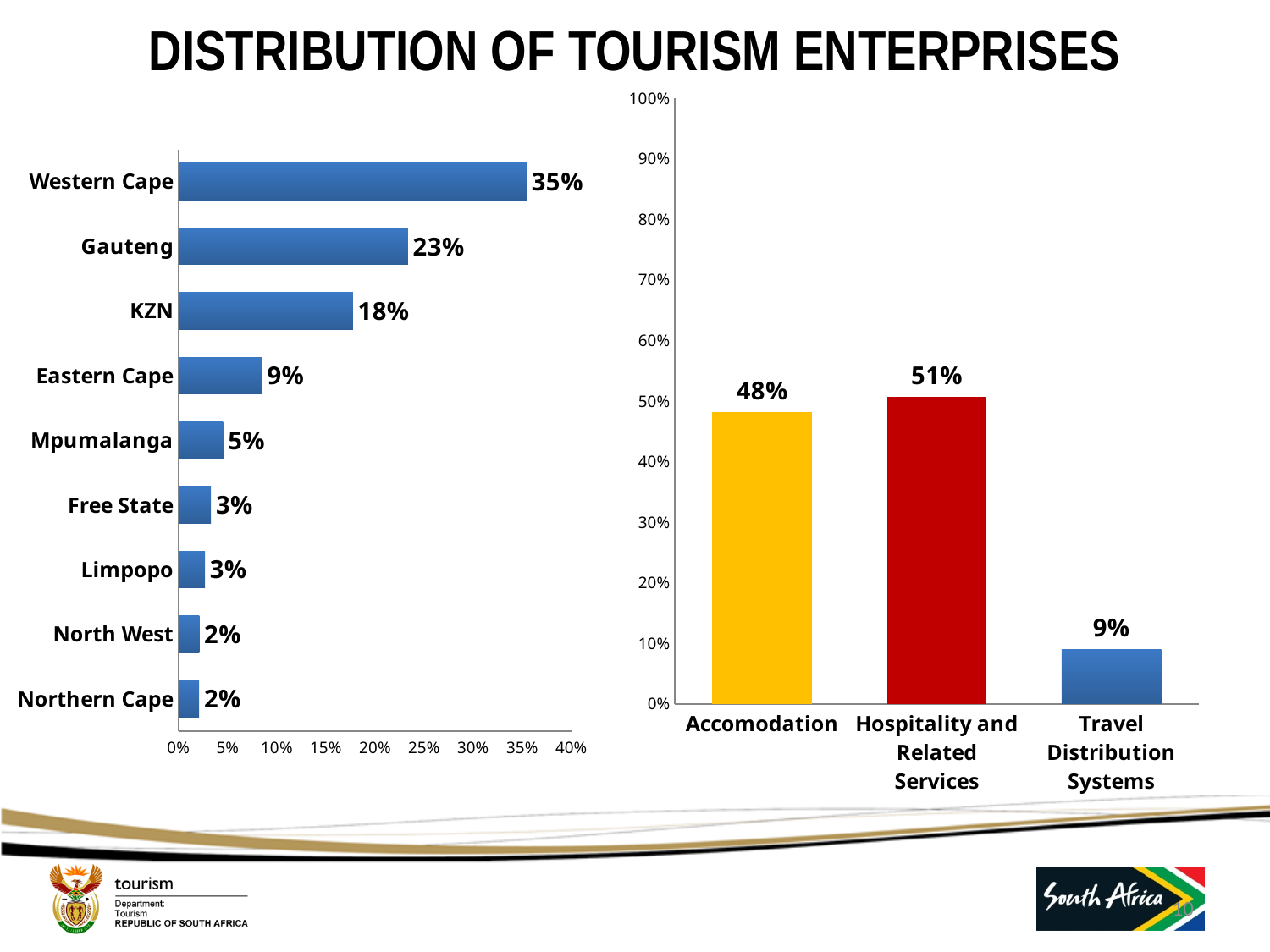
In the left chart (provinces), how many provinces are shown? 9 In the right chart (enterprise types), how many categories are shown? 3 In the left chart (provinces), what is the difference between Gauteng and Eastern Cape? 14% In the left chart (provinces), which is larger, Mpumalanga or Free State? Mpumalanga In the right chart (enterprise types), which category has the lowest value? Travel Distribution Systems In the left chart (provinces), what is the value for KZN? 18% In the right chart (enterprise types), what is the value for Accomodation? 48% In the right chart (enterprise types), what is the difference between Hospitality and Related Services and Accomodation? 3% In the right chart (enterprise types), what colour is the bar for Hospitality and Related Services? Red In the left chart (provinces), which province has the highest value? Western Cape In the left chart (provinces), what kind of chart is it? Bar chart In the left chart (provinces), what is the value for Western Cape? 35%